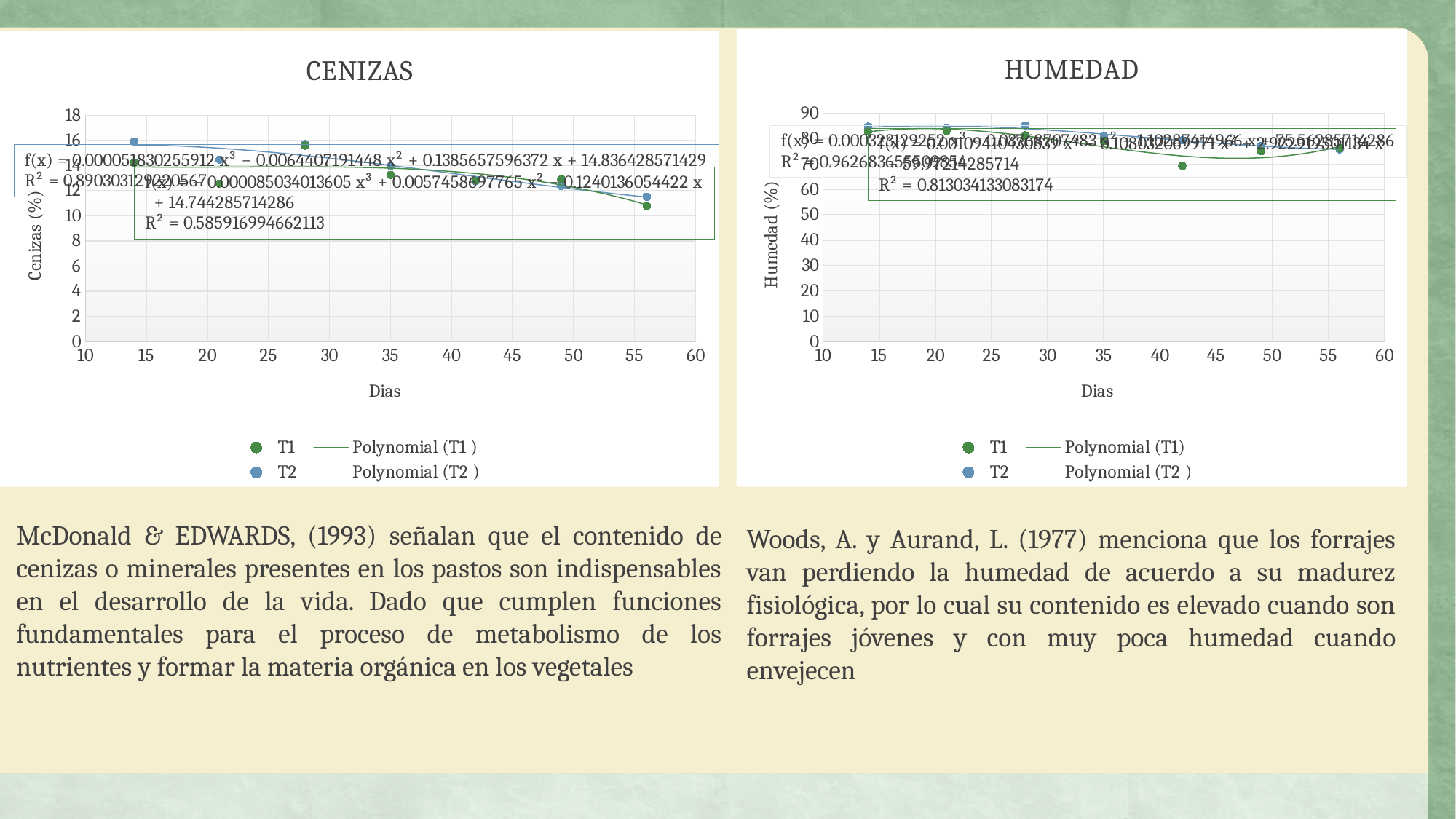
What is the R² value shown for the T1 polynomial trendline in the CENIZAS chart? 0.585916994662113 In the CENIZAS chart, is the T1 value at day 56 greater or less than 12? less In the CENIZAS chart, at which day is the T1 value lowest? 56 What is the y-axis label of the HUMEDAD chart? Humedad (%) In the HUMEDAD chart, is the T1 value at day 42 greater or less than 80? less In the HUMEDAD chart, is the T1 value at day 14 greater or less than 80? greater In the CENIZAS chart, do the T2 values generally rise or fall as the days increase? fall In the HUMEDAD chart, at which day is the T1 value lowest? 42 What type of chart is the CENIZAS chart? scatter chart How many series does the legend of the HUMEDAD chart list? 4 In the CENIZAS chart, how many data points are plotted for series T1? 7